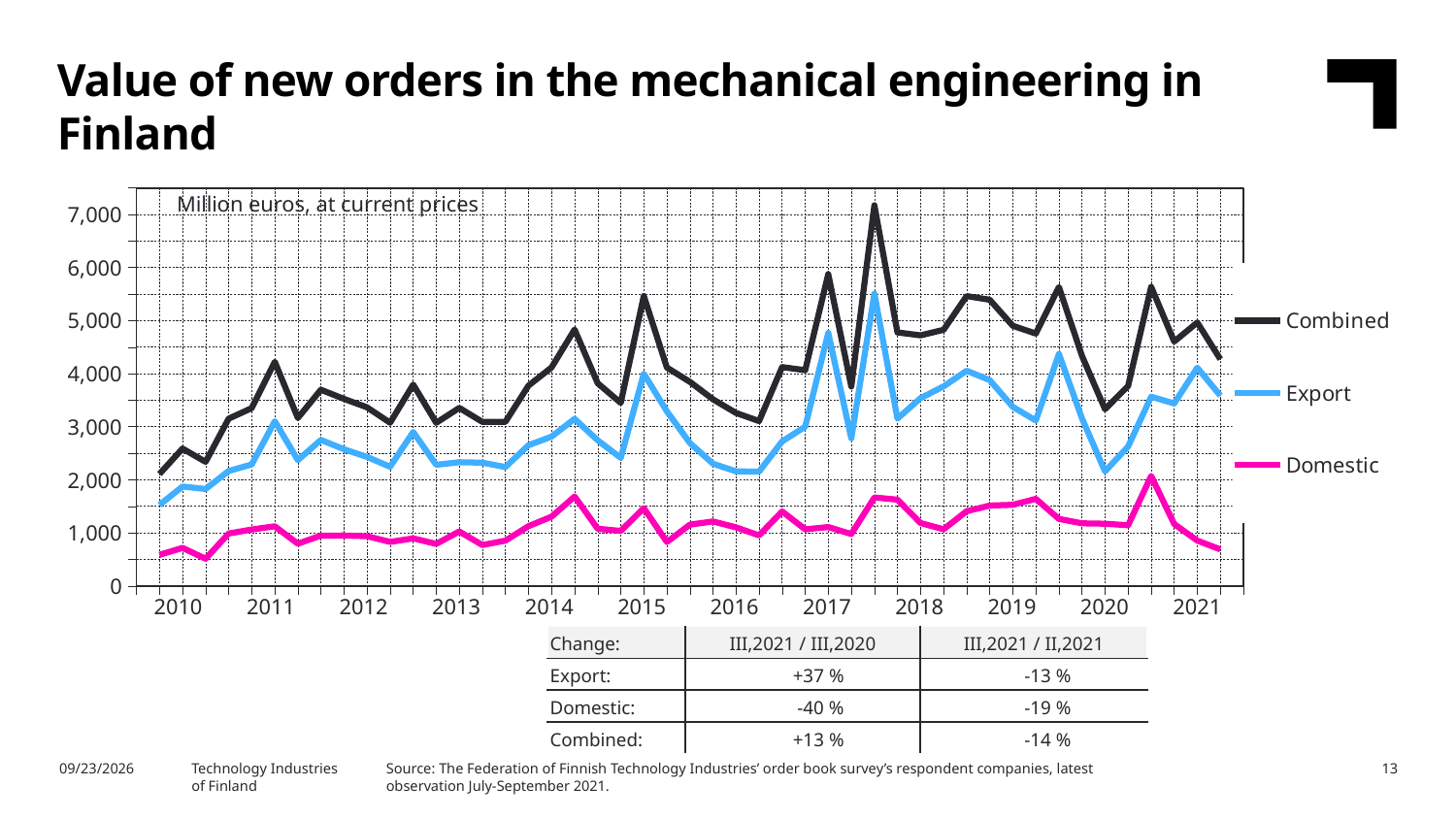
Which series has the highest values across the whole chart? Combined Is the peak value of the Combined series in 2017 greater or less than 6,000? greater Is the first Export value in 2010 greater or less than 2,000? less Which is larger at the end of 2021, the Combined value or the Domestic value? Combined What type of chart is shown on the slide? line chart Is the Domestic peak in 2020 greater or less than 1,500? greater Which series has the lowest values across the whole chart? Domestic How many years are labeled on the x axis? 12 What unit is stated at the top of the chart area? Million euros, at current prices How many series does the legend list? 3 What are the three series named in the legend? Combined, Export, Domestic